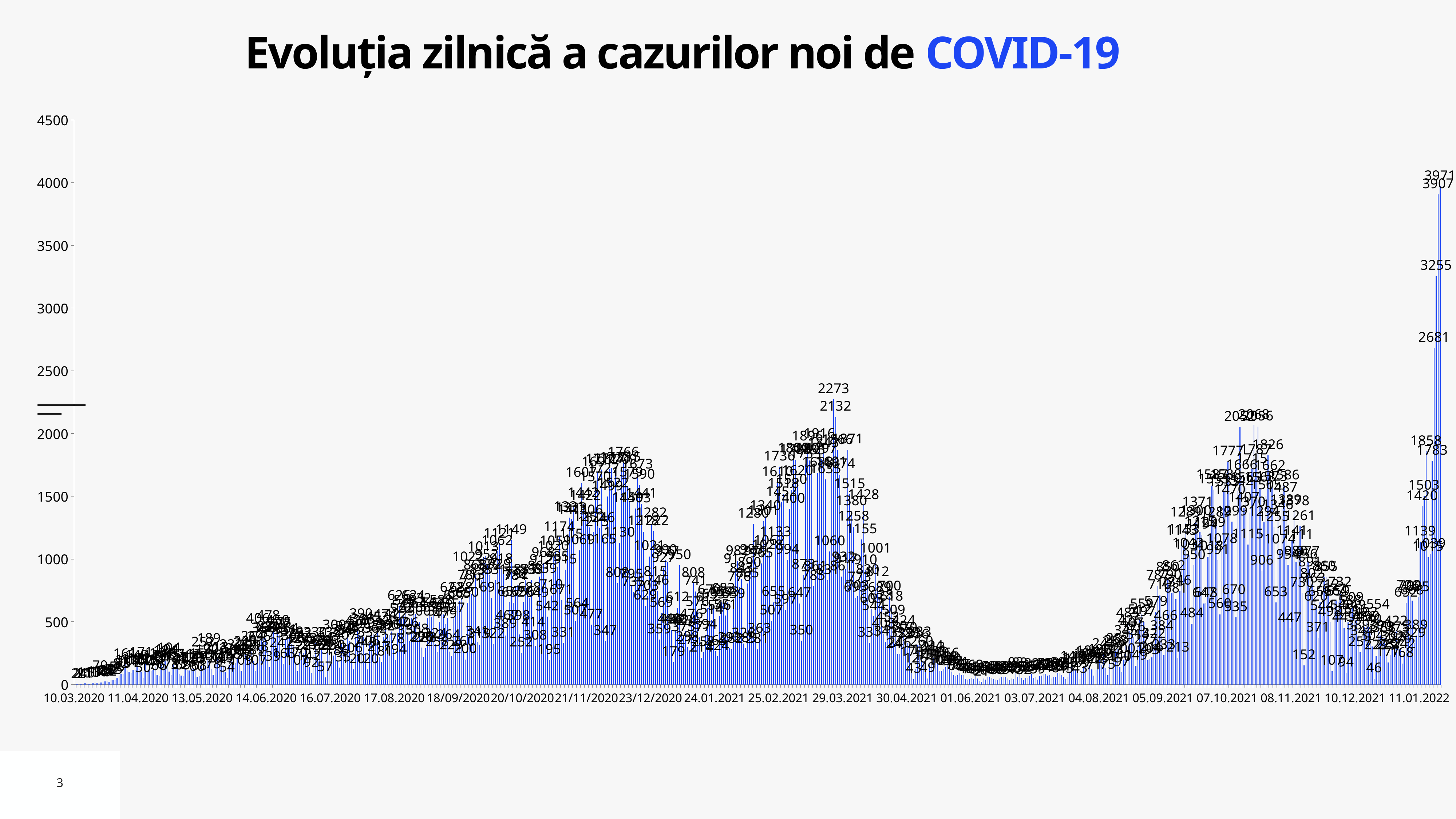
What is the highest value labeled in the wave peaking around 29.03.2021? 2273 Which is larger: the peak of the wave around 29.03.2021 or the peak of the wave around 11.01.2022? the peak around 11.01.2022 What kind of chart is shown on the slide? bar chart What is the first date label on the horizontal axis? 10.03.2020 What is the difference between the highest value on the chart (3971) and the peak of the wave around 29.03.2021 (2273)? 1698 What is the title of the chart? Evoluția zilnică a cazurilor noi de COVID-19 Do the values rise or fall between 04.08.2021 and 07.10.2021? rise Is the highest value on the chart greater or less than 3500? greater What is the maximum value shown on the vertical axis? 4500 What is the highest value labeled on the chart? 3971 Are the daily values around 01.06.2021 greater or less than 500? less Do the values rise or fall between 29.03.2021 and 01.06.2021? fall